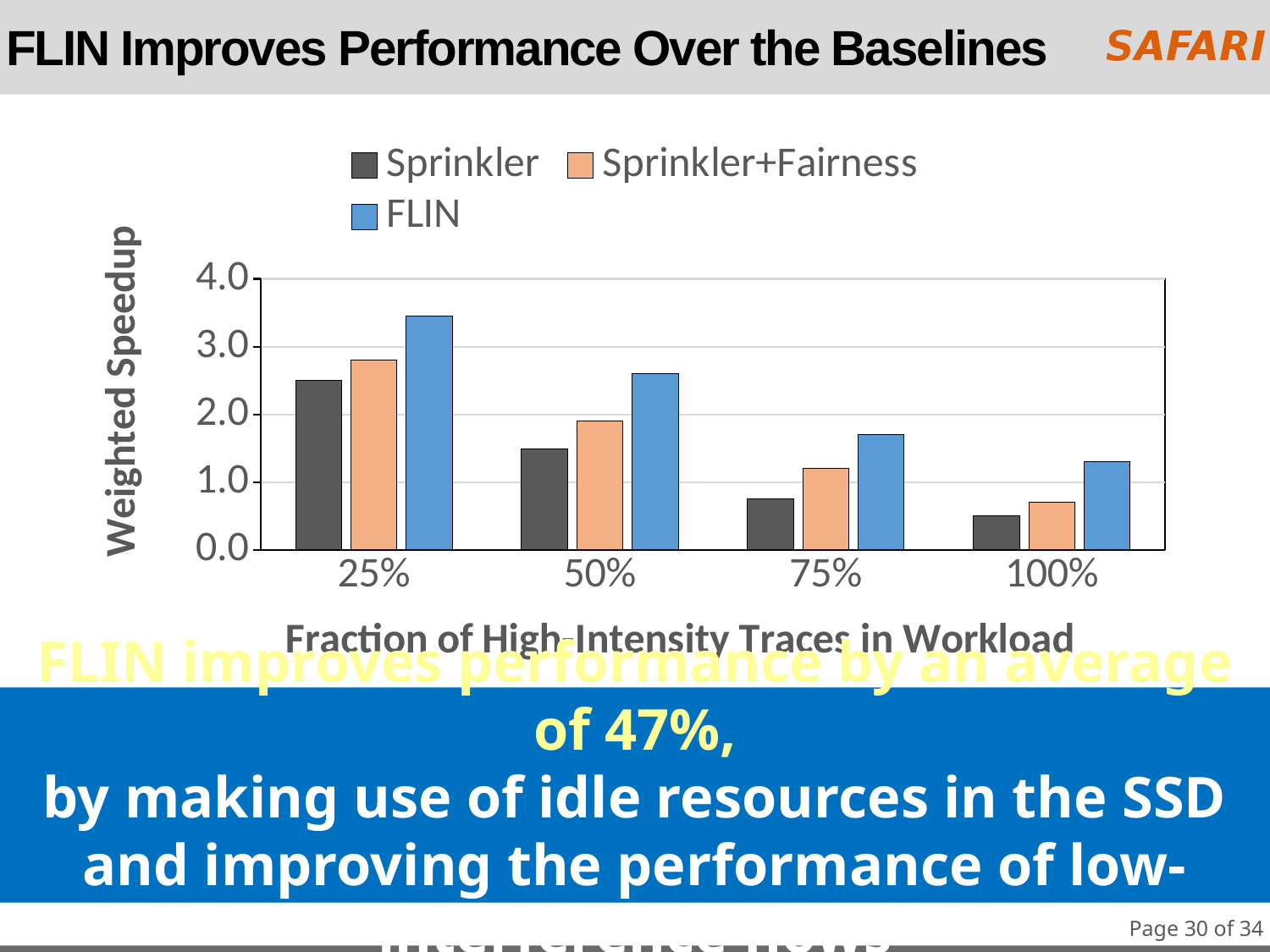
At which fraction of high-intensity traces is the FLIN weighted speedup highest? 25% How many categories are shown on the x axis? 4 Which series has the lowest weighted speedup at 100%? Sprinkler How many series does the legend list? 3 Is the weighted speedup for FLIN at 25% greater or less than 3.0? greater Which series has the highest weighted speedup at 25%? FLIN Is the weighted speedup for Sprinkler+Fairness at 50% greater or less than 2.0? less Do the FLIN weighted speedup values rise or fall as the fraction of high-intensity traces increases from 25% to 100%? fall What is the label of the y axis? Weighted Speedup Which is larger at 50%: the weighted speedup for Sprinkler or for FLIN? FLIN What kind of chart is shown on the slide? bar chart Is the weighted speedup for Sprinkler at 75% greater or less than 1.0? less